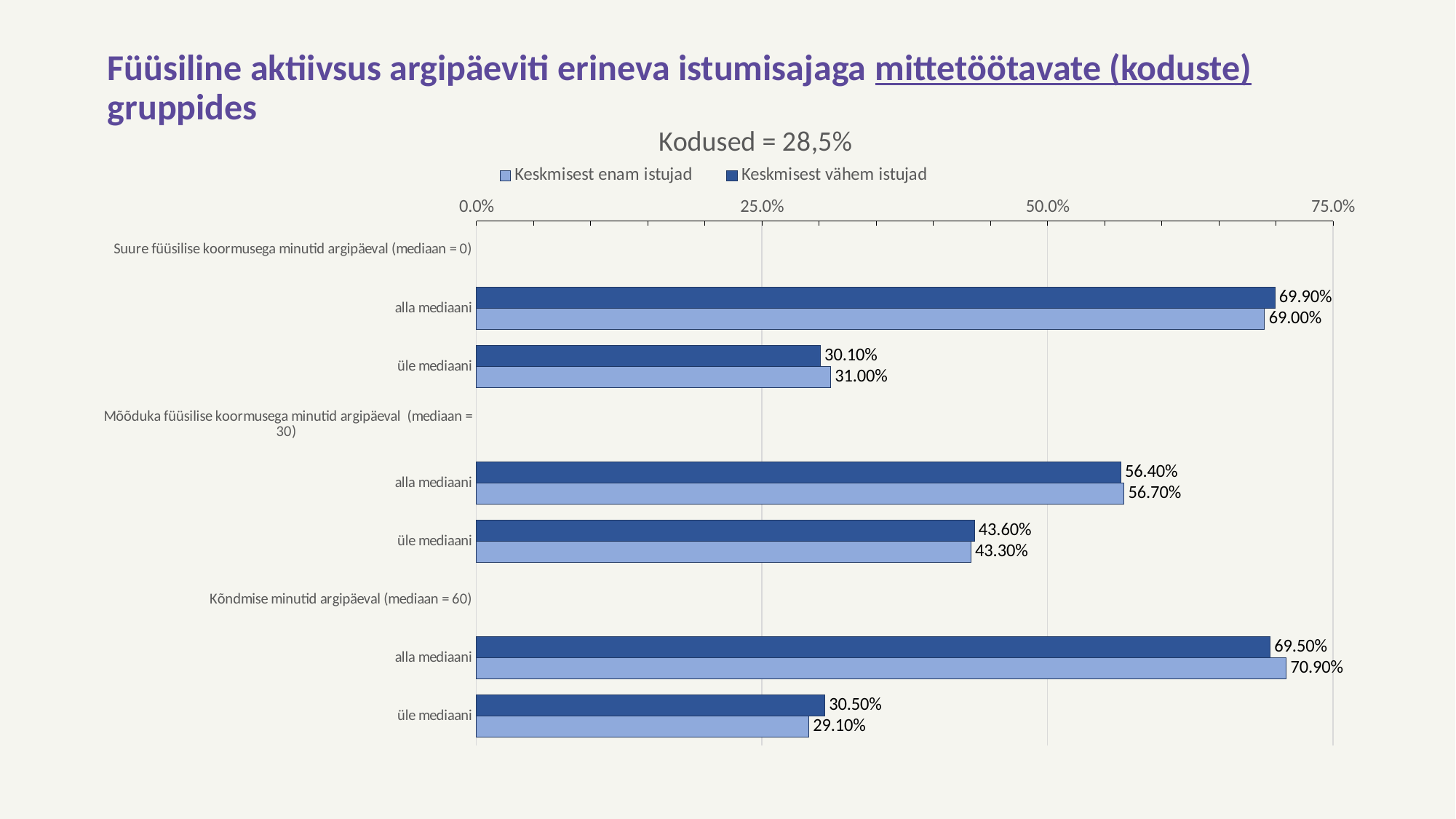
What is the value for 'Keskmisest enam istujad' in the 'alla mediaani' row under 'Mõõduka füüsilise koormusega minutid argipäeval (mediaan = 30)'? 56.70% What is the value for 'Keskmisest vähem istujad' in the 'alla mediaani' row under 'Suure füüsilise koormusega minutid argipäeval (mediaan = 0)'? 69.90% What is the value for 'Keskmisest vähem istujad' in the 'üle mediaani' row under 'Kõndmise minutid argipäeval (mediaan = 60)'? 30.50% What is the value for 'Keskmisest enam istujad' in the 'üle mediaani' row under 'Suure füüsilise koormusega minutid argipäeval (mediaan = 0)'? 31.00% What kind of chart is shown on the slide? bar chart In the 'üle mediaani' row under 'Mõõduka füüsilise koormusega minutid argipäeval (mediaan = 30)', which series has the larger value: 'Keskmisest vähem istujad' (43.60%) or 'Keskmisest enam istujad' (43.30%)? Keskmisest vähem istujad Which series has the highest value in the chart, and what is it? Keskmisest enam istujad, 70.90% What is the lowest value shown in the chart? 29.10% Is the value for 'Keskmisest vähem istujad' in the 'alla mediaani' row under 'Mõõduka füüsilise koormusega minutid argipäeval (mediaan = 30)' greater or less than 50.0%? greater How many series does the legend list? 2 What is the title of the chart? Kodused = 28,5% What is the difference between 'Keskmisest enam istujad' and 'Keskmisest vähem istujad' in the 'alla mediaani' row under 'Kõndmise minutid argipäeval (mediaan = 60)'? 1.40%